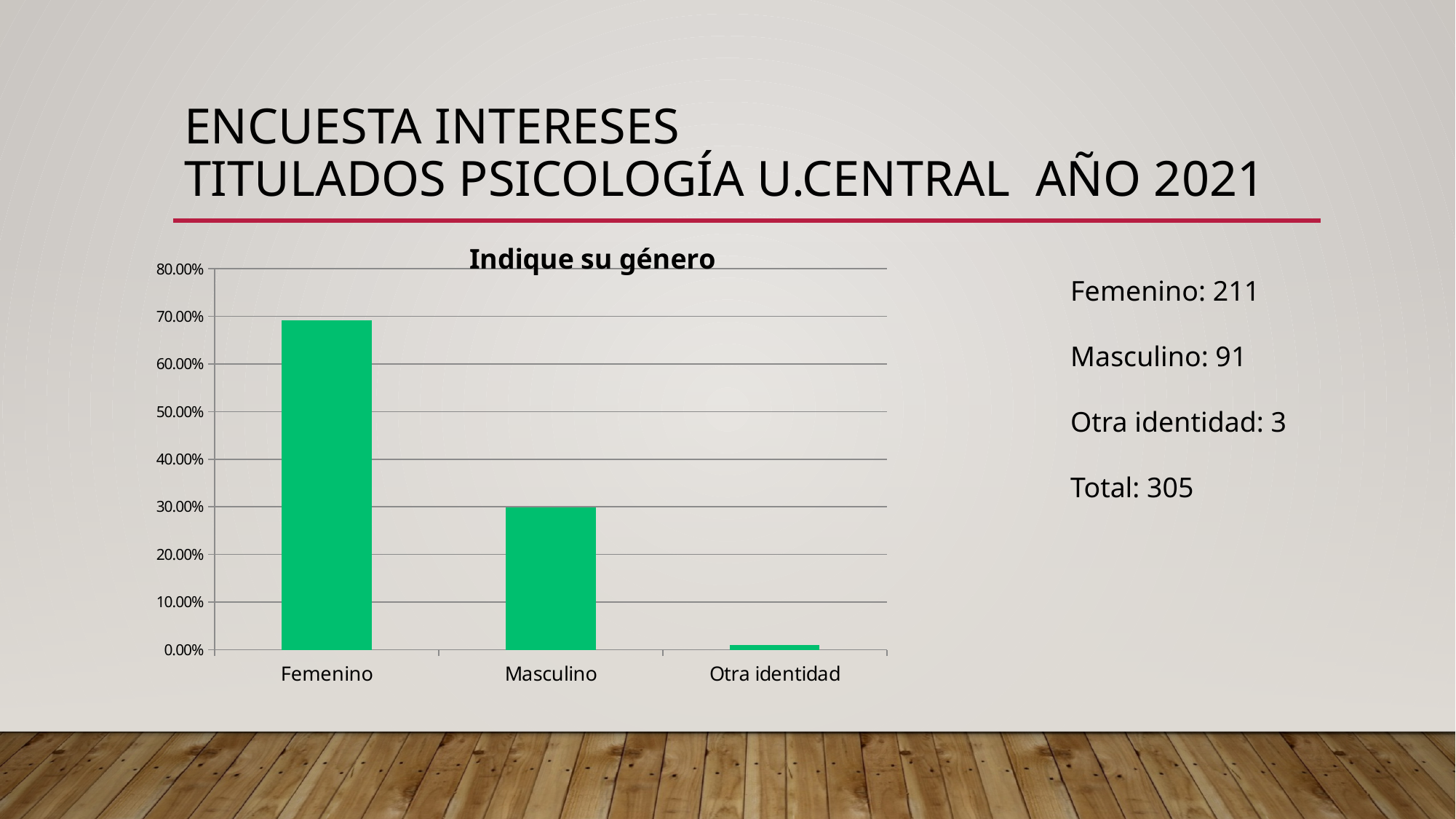
Is the value for Masculino greater or less than 20.00%? greater Is the value for Femenino greater or less than 60.00%? greater Is the value for Masculino greater or less than 40.00%? less Which category has the lowest value in the chart? Otra identidad Which is larger, the value for Femenino or the value for Masculino? Femenino What is the title of the chart? Indique su género How many categories are shown on the x axis of the chart? 3 What type of chart is shown on the slide? bar chart Do the bar values rise or fall from left to right across the x axis? fall Which category has the highest value in the chart? Femenino